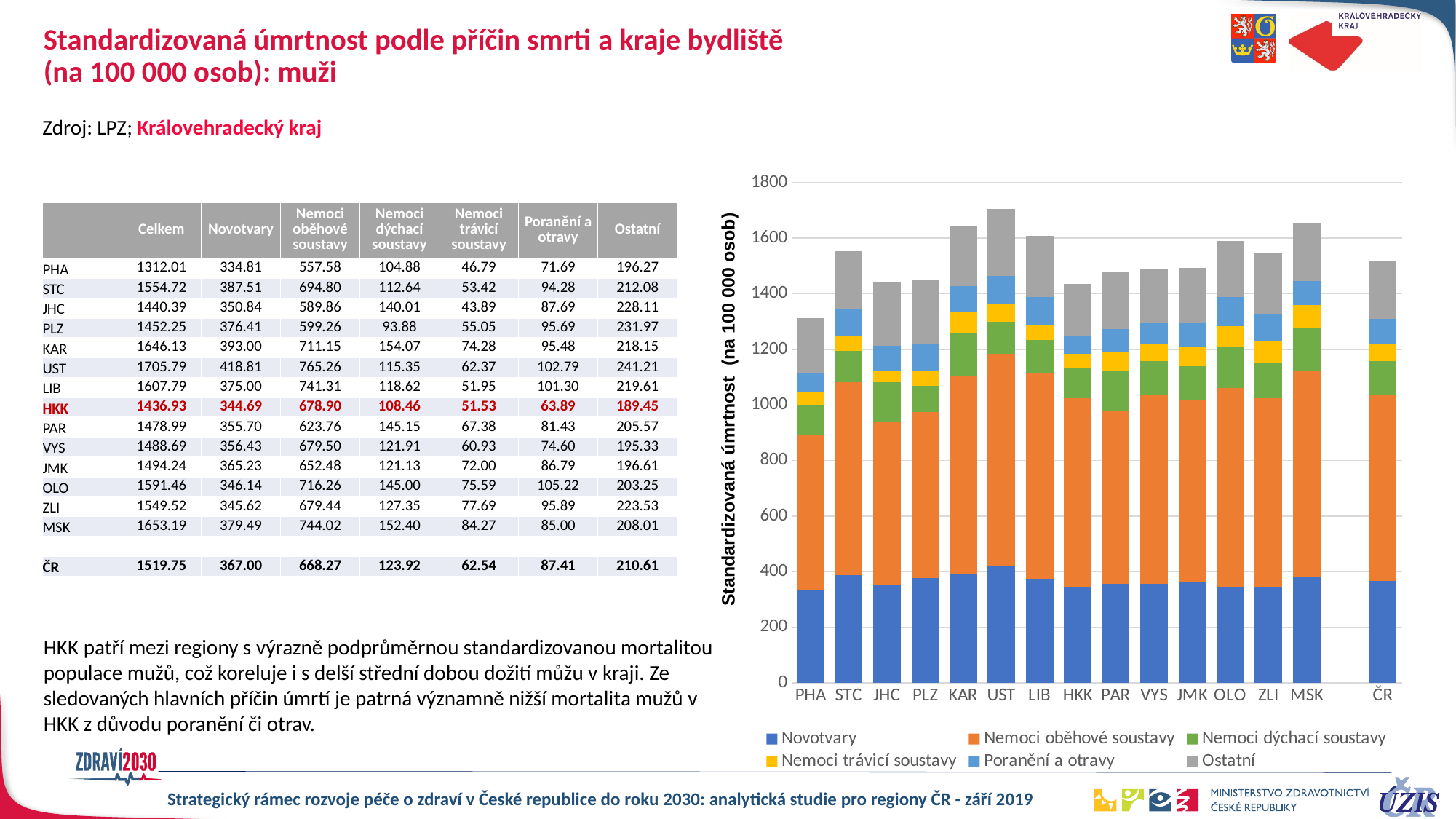
What colour represents Novotvary in the chart? blue According to the table, what is the value of Poranění a otravy for HKK? 63.89 How many regions (bars) are plotted on the x axis of the chart, including ČR? 15 Is the total bar height for HKK greater or less than 1600? less What kind of chart is shown on the right of the slide? stacked bar chart Using the Celkem values in the table, what is the difference between ČR and HKK? 82.82 Which has the larger total standardized mortality, PHA or STC? STC Is the total bar height for UST greater or less than 1600? greater According to the table, what is the Celkem (total) standardized mortality for HKK? 1436.93 Which region has the highest total standardized mortality in the chart? UST How many series does the chart legend list? 6 Which region has the lowest total standardized mortality in the chart? PHA